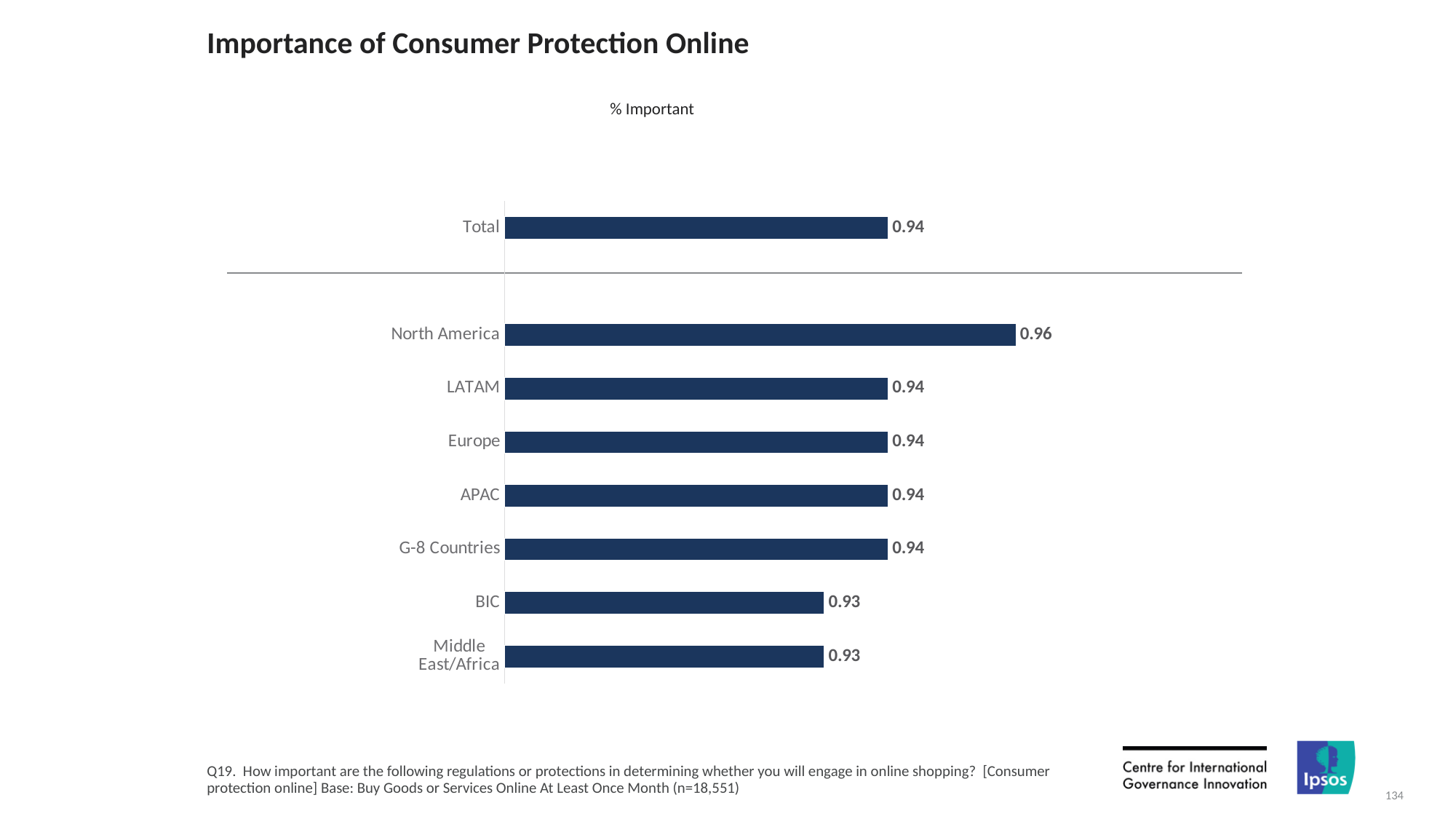
Which region has the highest value? North America What is the value for Middle East/Africa? 0.93 Which is larger, the value for North America or the value for LATAM? North America What is the value for G-8 Countries? 0.94 What is the value for North America? 0.96 What is the title of the slide? Importance of Consumer Protection Online What is the difference between the values for North America and Europe? 0.02 What kind of chart is shown on the slide? Bar chart What is the value for BIC? 0.93 How many bars are shown in the chart, including Total? 8 What is the value for Total? 0.94 What is the difference between the values for North America and BIC? 0.03